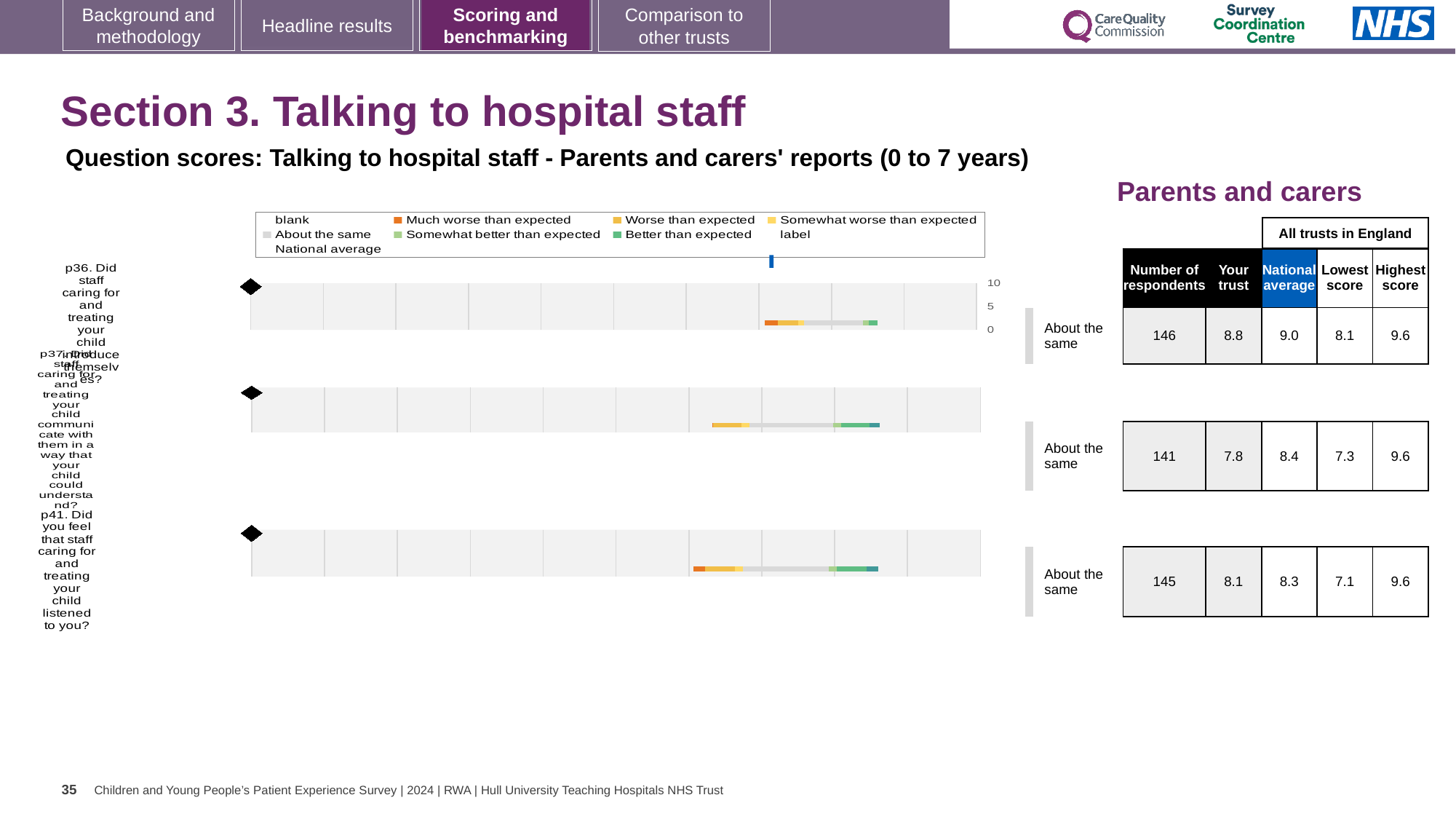
Which question has the lowest 'Your trust' score? p37 For p41, which is larger: the 'Your trust' score or the National average? National average What is the Highest score shown for p36? 9.6 What is the National average shown for p37 (Did staff communicate with them in a way that your child could understand)? 8.4 How many entries does the chart legend list? 9 What kind of chart is shown on the slide? bar chart What is the number of respondents shown for p41 (Did you feel that staff caring for and treating your child listened to you)? 145 What benchmark label is shown next to the p36 row? About the same What is the 'Your trust' score shown for p36 (Did staff caring for and treating your child introduce themselves)? 8.8 Which question has the highest 'Your trust' score? p36 How many survey questions (rows) are plotted in the chart? 3 What is the difference between the National average and the 'Your trust' score for p36? 0.2